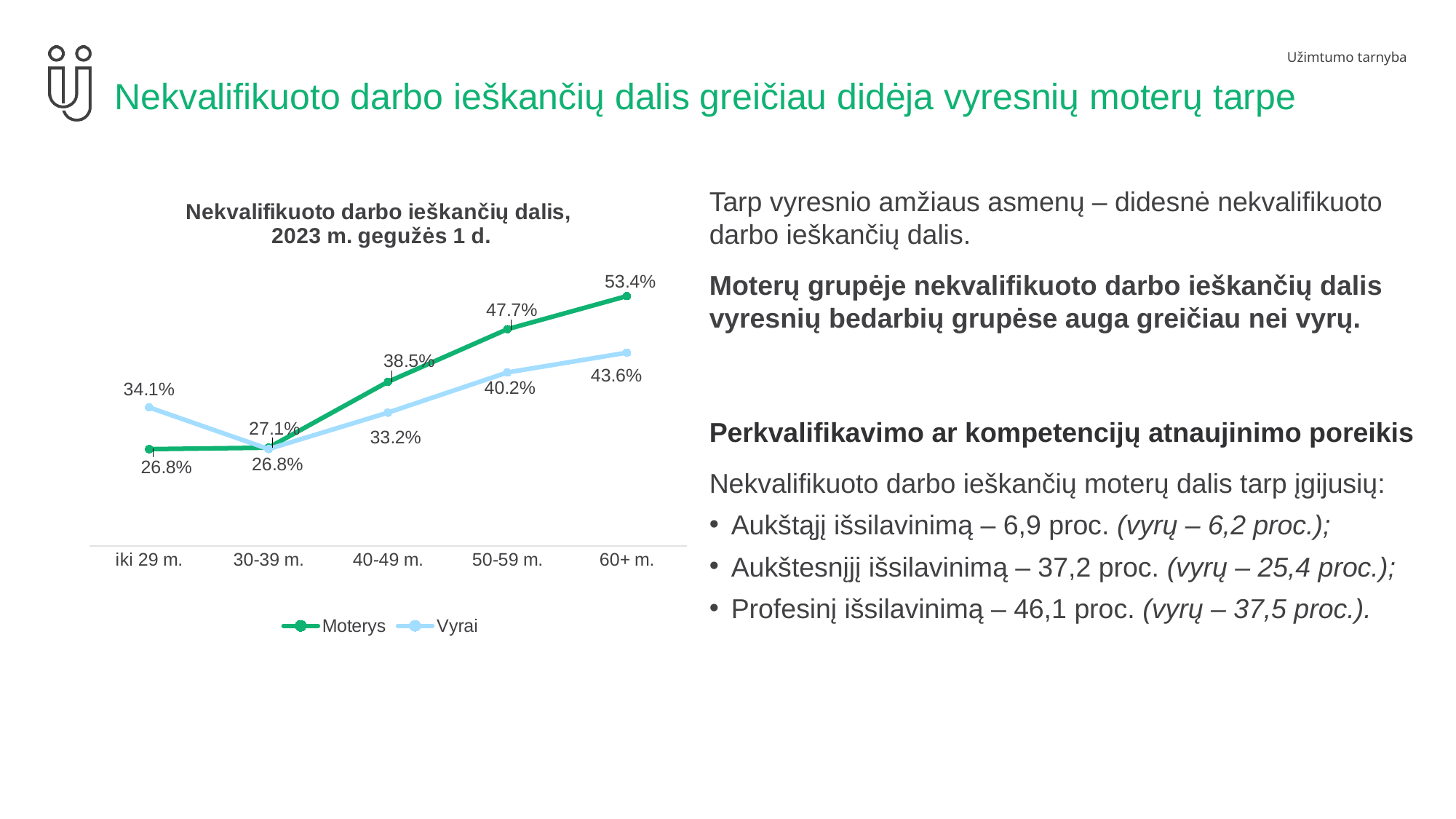
In which age group is the Moterys value highest? 60+ m. In the iki 29 m. age group, which series has the larger value, Moterys or Vyrai? Vyrai What is the value for Vyrai in the 50-59 m. age group? 40.2% What is the difference between the Moterys and Vyrai values in the 60+ m. age group? 9.8 percentage points In which age group is the Vyrai value lowest? 30-39 m. How many age groups are shown on the x axis? 5 What is the value for Vyrai in the iki 29 m. age group? 34.1% Does the Moterys series rise or fall from the 30-39 m. group to the 60+ m. group? rise What is the value for Moterys in the 40-49 m. age group? 38.5% What is the value for Moterys in the 60+ m. age group? 53.4% How many series does the legend list? 2 What type of chart is shown on the slide? line chart